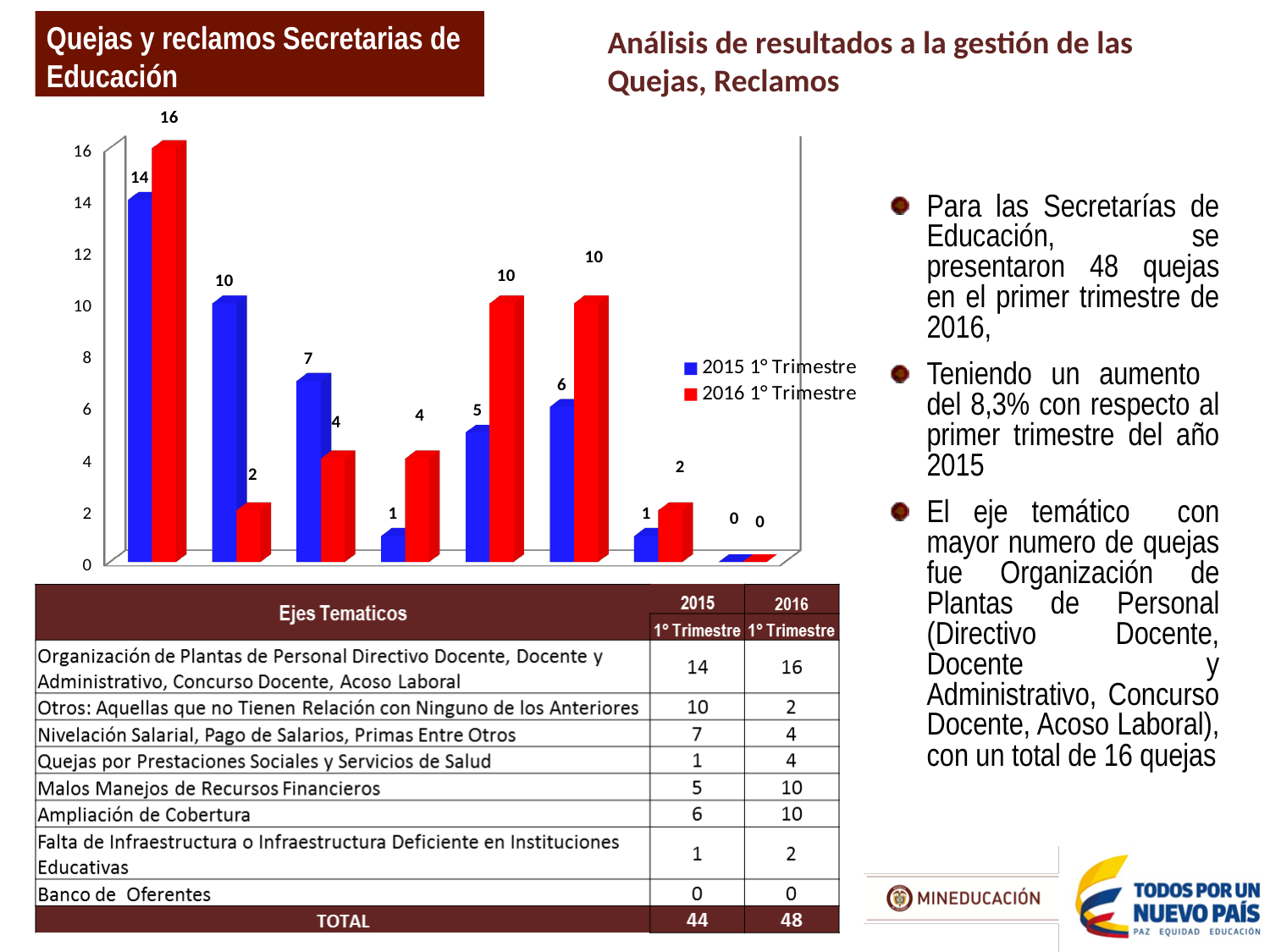
What is the total of all 2015 1° Trimestre values plotted in the chart? 44 What colour represents the 2016 1° Trimestre series in the chart? red In the fifth group of bars (Malos Manejos de Recursos Financieros), which series has the larger value? 2016 1° Trimestre In the chart, what is the 2015 1° Trimestre value for the third group of bars (Nivelación Salarial)? 7 What kind of chart is shown on the slide? bar chart In the chart, what is the 2016 1° Trimestre value for the first group of bars (Organización de Plantas de Personal)? 16 Which group of bars has the highest 2015 1° Trimestre value in the chart? the first group (Organización de Plantas de Personal), 14 In the second group of bars (Otros), what is the difference between the 2015 1° Trimestre value and the 2016 1° Trimestre value? 8 How many series does the chart's legend list? 2 How many groups of bars (categories) are plotted in the chart? 8 In the chart, what is the 2016 1° Trimestre value for the sixth group of bars (Ampliación de Cobertura)? 10 Which group of bars has the lowest values in the chart for both series? the last group (Banco de Oferentes), 0